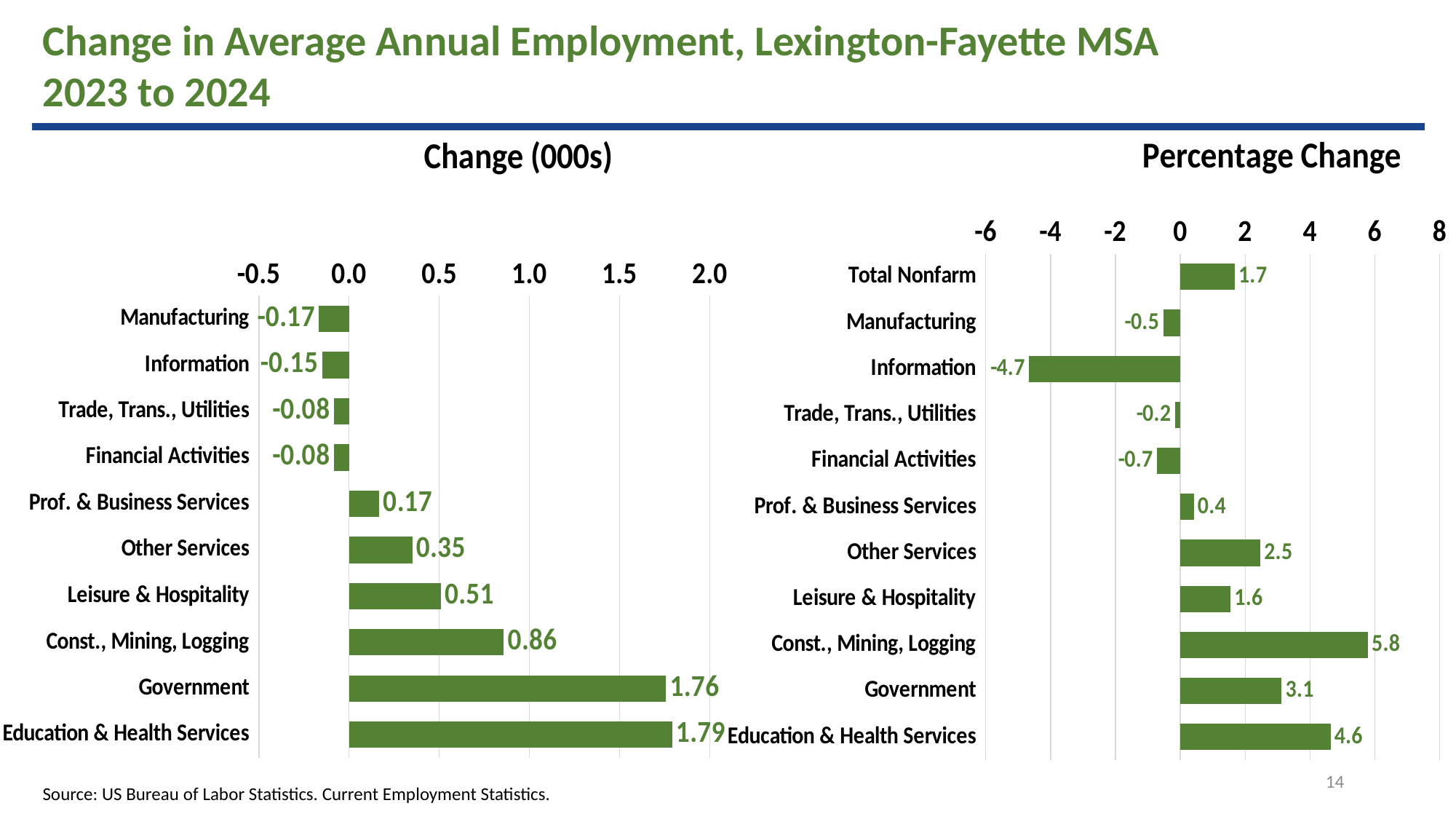
In the Change (000s) chart, what is the difference between Government and Const., Mining, Logging? 0.90 In the Percentage Change chart, which is larger, Other Services or Leisure & Hospitality? Other Services In the Change (000s) chart, which category has the highest value? Education & Health Services In the Percentage Change chart, what is the value for Information? -4.7 In the Percentage Change chart, which category has the lowest value? Information In the Percentage Change chart, which category has the highest value? Const., Mining, Logging In the Change (000s) chart, what is the value for Trade, Trans., Utilities? -0.08 How many categories are shown in the Percentage Change chart? 11 What kind of chart is the Change (000s) chart? Bar chart How many categories are shown in the Change (000s) chart? 10 In the Percentage Change chart, what is the value for Total Nonfarm? 1.7 In the Change (000s) chart, what is the value for Government? 1.76